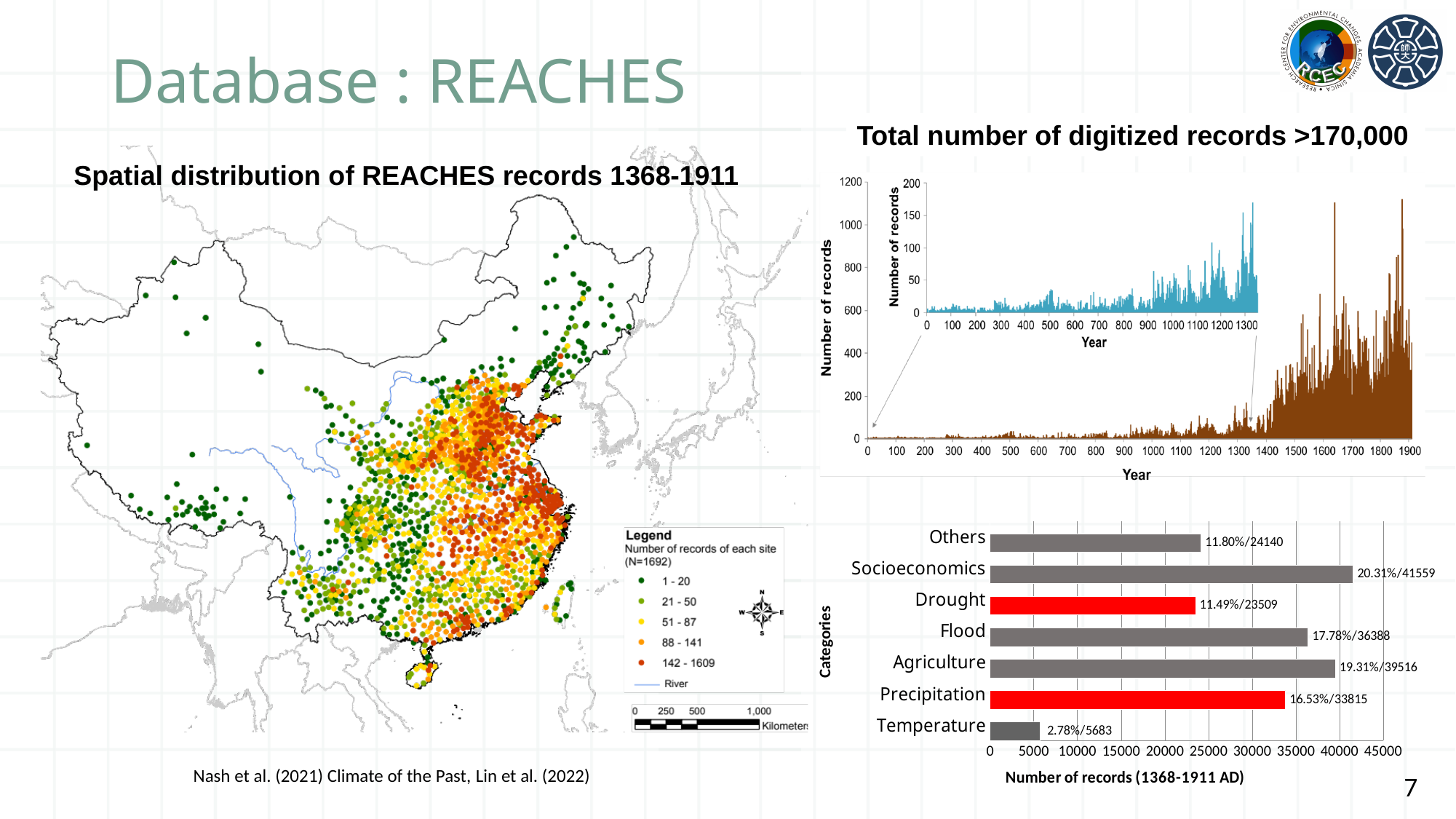
In the bottom-right bar chart, what is the difference in number of records between Agriculture and Flood? 3128 In the bottom-right bar chart, what is the data label for Socioeconomics? 20.31%/41559 In the bottom-right bar chart, which category has the lowest number of records? Temperature In the bottom-right bar chart, which has more records, Drought or Others? Others How many categories are shown in the bottom-right bar chart? 7 In the bottom-right bar chart, which categories are drawn in red? Drought and Precipitation What kind of chart is the bottom-right chart with categories such as Drought and Flood? bar chart In the top-right chart of number of records by year, do the values generally rise or fall as the year increases toward 1900? rise In the bottom-right bar chart, which category has the highest number of records? Socioeconomics In the bottom-right bar chart, is the value for Precipitation greater or less than 30000? greater In the bottom-right bar chart, what is the data label for Temperature? 2.78%/5683 In the bottom-right bar chart, what is the difference in number of records between Socioeconomics and Temperature? 35876